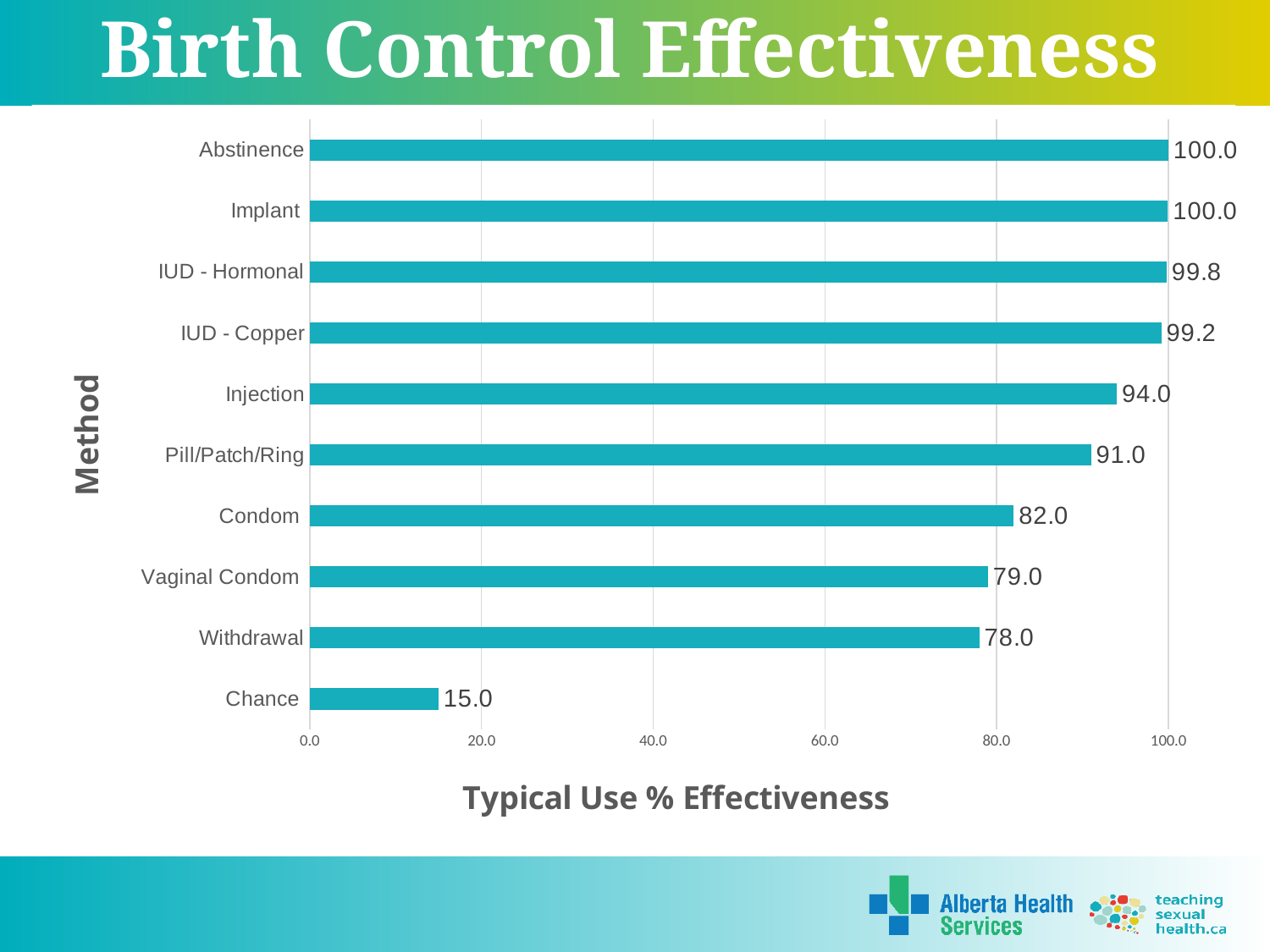
What is the typical use % effectiveness for Injection? 94.0 What kind of chart is shown on the slide? Bar chart What is the typical use % effectiveness for Withdrawal? 78.0 What is the typical use % effectiveness for IUD - Copper? 99.2 What is the difference in typical use % effectiveness between IUD - Hormonal and Injection? 5.8 Which has a higher typical use % effectiveness, Condom or Withdrawal? Condom Which method has the lowest typical use % effectiveness? Chance What is the typical use % effectiveness for Condom? 82.0 What is the label of the horizontal axis? Typical Use % Effectiveness What is the difference in typical use % effectiveness between Pill/Patch/Ring and Vaginal Condom? 12.0 Is the value for Chance greater or less than 20.0? less How many methods are shown in the chart? 10